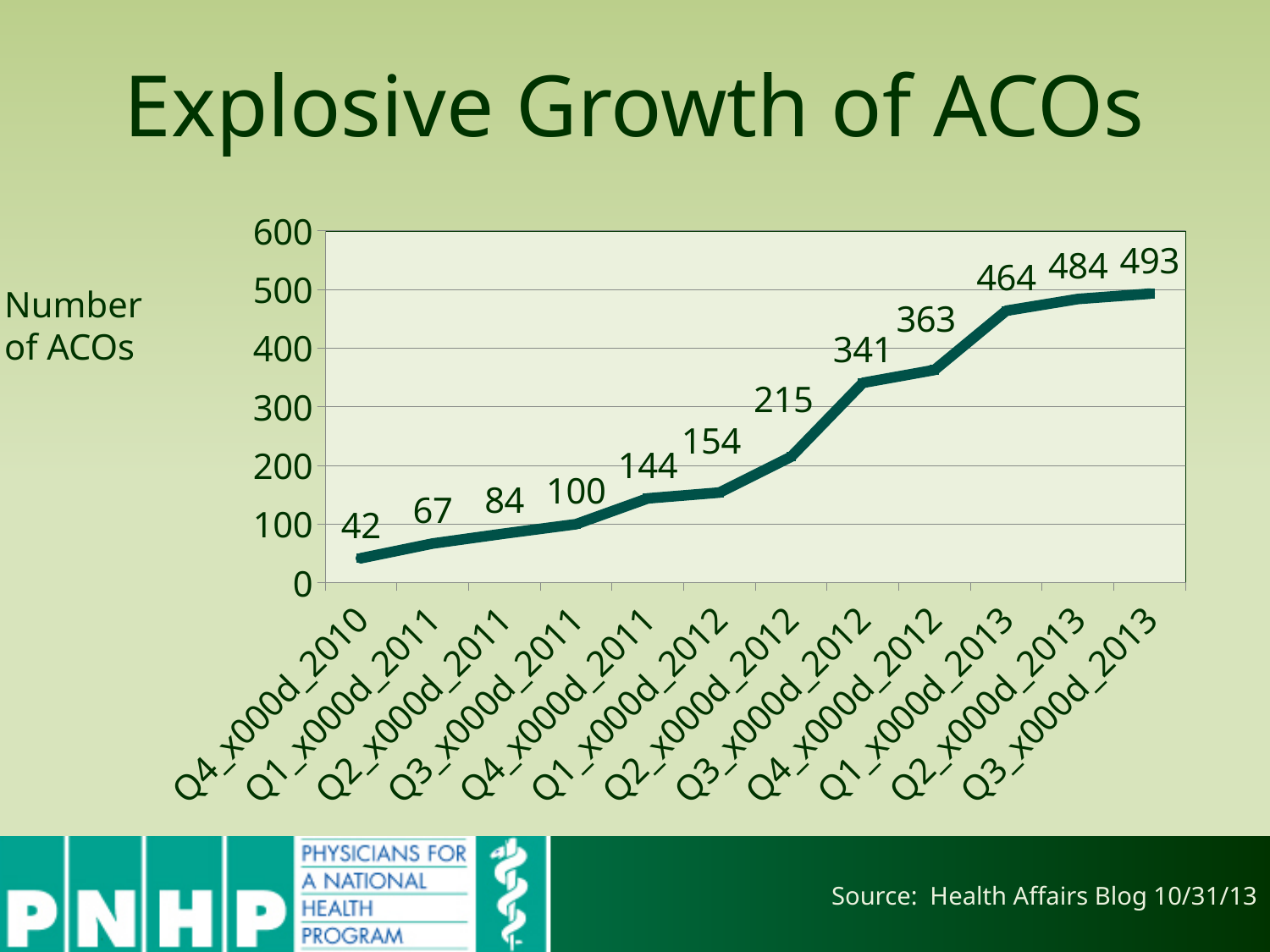
Is the value for Q1_x000d_2013 greater or less than 400? greater What is the number of ACOs for the category labelled Q2_x000d_2013? 484 What is the number of ACOs for the category labelled Q3_x000d_2012? 341 How many data points are plotted on the chart? 12 Do the values rise or fall along the x axis from Q4_x000d_2010 to Q3_x000d_2013? rise Which category has the lowest number of ACOs? Q4_x000d_2010 Which category has the highest number of ACOs? Q3_x000d_2013 What is the difference between the number of ACOs for Q3_x000d_2013 and Q4_x000d_2010? 451 What is the difference between the number of ACOs for Q3_x000d_2012 and Q2_x000d_2012? 126 Which has a larger number of ACOs, Q1_x000d_2012 or Q4_x000d_2011? Q1_x000d_2012 What kind of chart is shown on the slide? line chart What is the number of ACOs for the category labelled Q4_x000d_2010? 42